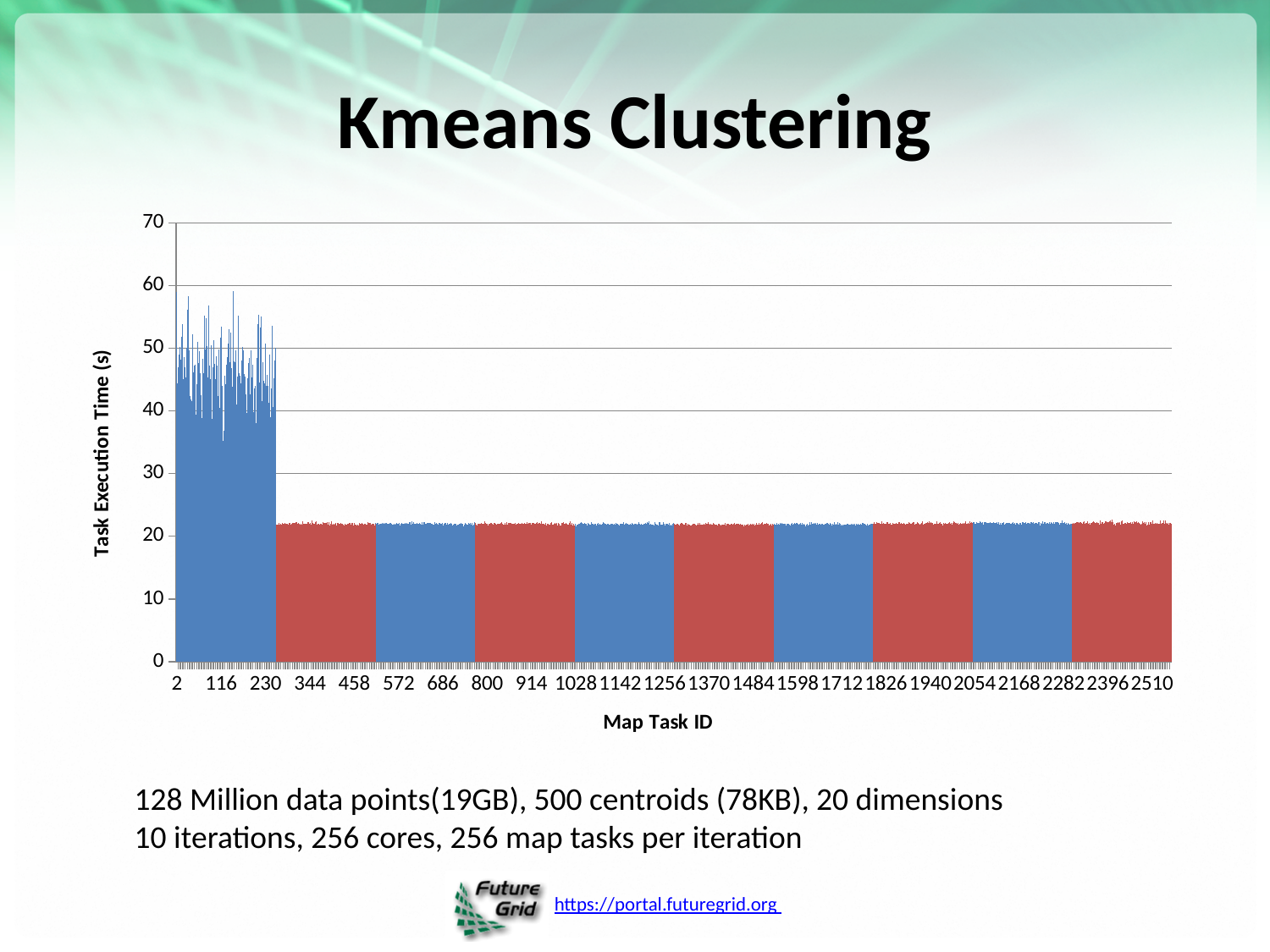
How many alternating coloured blocks of bars are shown along the x axis? 10 Is the value for Map Task ID 116 greater or less than 30? greater Is the value for Map Task ID 2510 greater or less than 40? less What is the highest value shown on the vertical axis of the chart? 70 What is the label of the vertical axis of the chart? Task Execution Time (s) Which block of map tasks has the highest execution times: the first block (IDs 2 to about 230) or the last block (IDs around 2396 to 2510)? the first block Do the task execution times rise or fall from the first block of map tasks to the later blocks along the x axis? fall What kind of chart is shown on the slide? bar chart Is the value for Map Task ID 1142 greater or less than 30? less What is the title of the chart on the slide? Kmeans Clustering